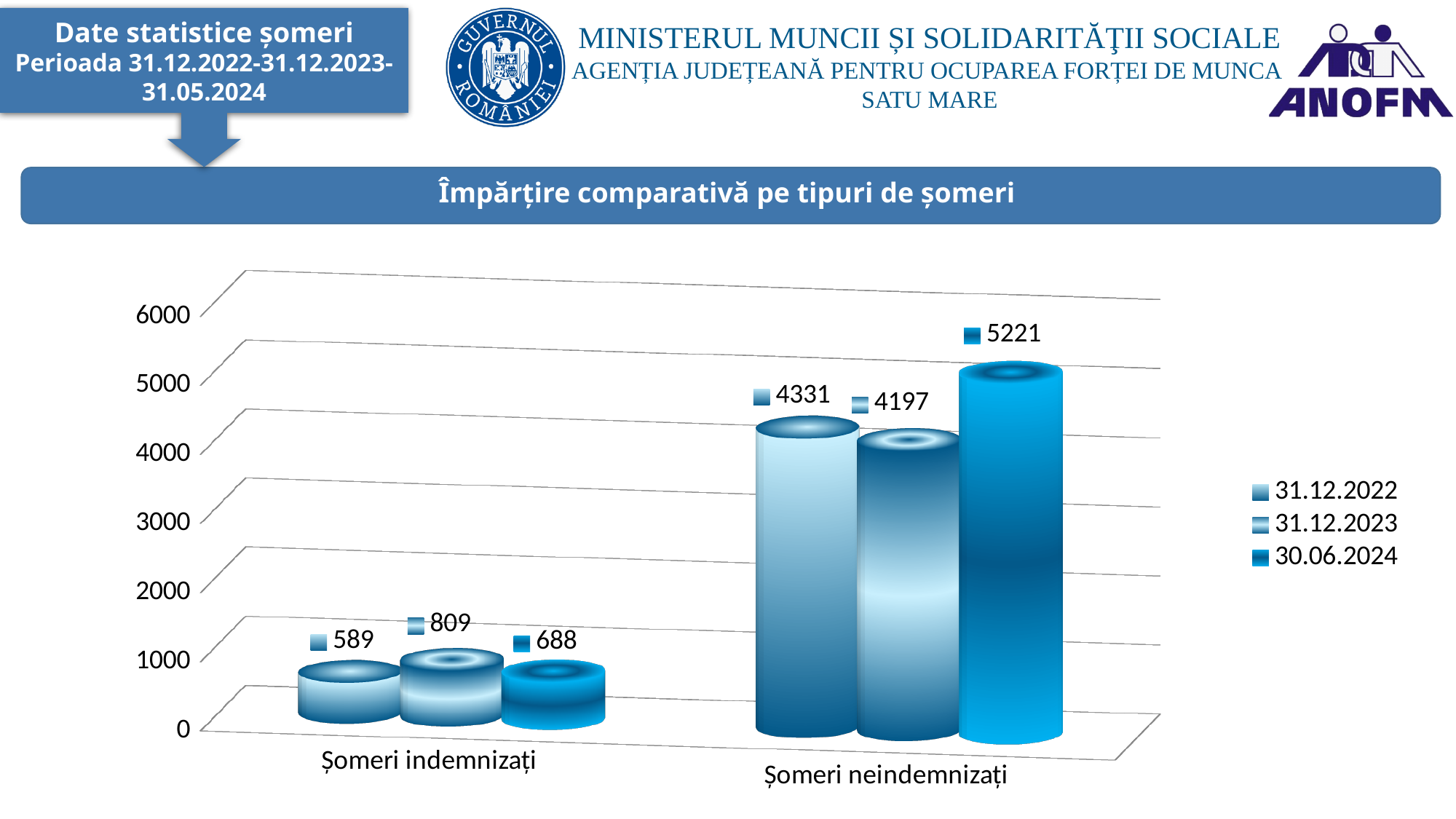
What is the title of the chart? Împărțire comparativă pe tipuri de șomeri What is the difference between the 31.12.2023 and 31.12.2022 values for Șomeri indemnizați? 220 Which is larger: the 31.12.2022 value for Șomeri neindemnizați or the 31.12.2023 value for Șomeri neindemnizați? 31.12.2022 What is the value for Șomeri neindemnizați in the 30.06.2024 series? 5221 How many series does the legend list? 3 What is the difference between the 30.06.2024 and 31.12.2022 values for Șomeri neindemnizați? 890 Which series has the highest value for Șomeri indemnizați? 31.12.2023 Is the 30.06.2024 value for Șomeri neindemnizați greater or less than 5000? greater How many categories are shown on the x axis? 2 Which series has the lowest value for Șomeri neindemnizați? 31.12.2023 What is the value for Șomeri neindemnizați in the 31.12.2023 series? 4197 What is the value for Șomeri indemnizați in the 31.12.2022 series? 589